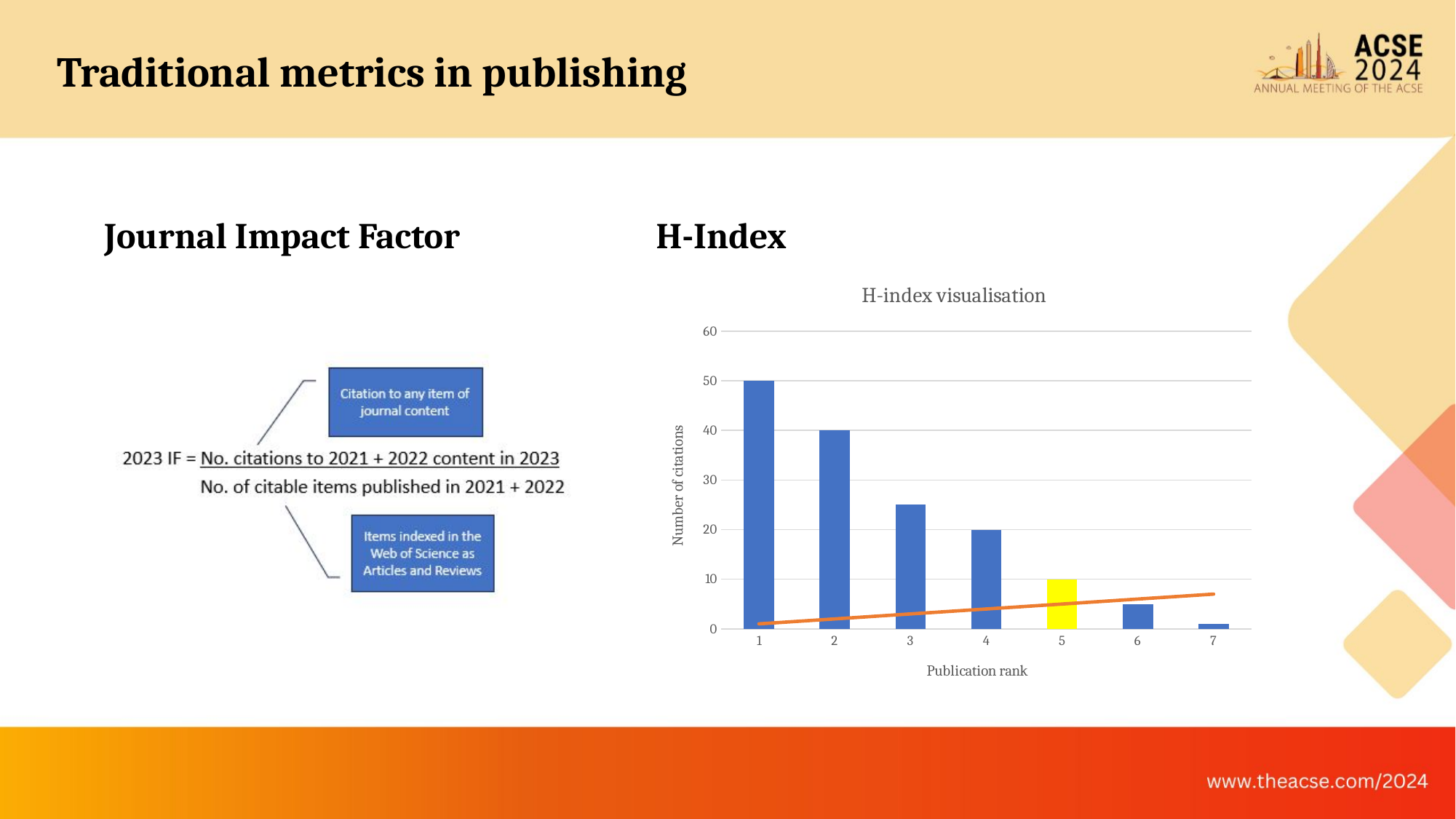
In the H-index visualisation, is the number of citations for publication rank 6 greater or less than 10? less In the H-index visualisation, is the number of citations for publication rank 3 greater or less than 30? less In the H-index visualisation, what is the number of citations for publication rank 2? 40 In the H-index visualisation, what is the number of citations for publication rank 4? 20 What kind of chart is the H-index visualisation? Combination bar and line chart In the H-index visualisation, what is the number of citations for publication rank 5? 10 In the H-index visualisation, which publication rank has the lowest number of citations? 7 In the H-index visualisation, what is the number of citations for publication rank 1? 50 In the H-index visualisation, do the number of citations rise or fall as publication rank increases? Fall In the H-index visualisation, what is the difference in citations between publication rank 1 and publication rank 2? 10 In the H-index visualisation, which publication rank has the highest number of citations? 1 How many publication ranks are shown on the x axis of the H-index visualisation? 7